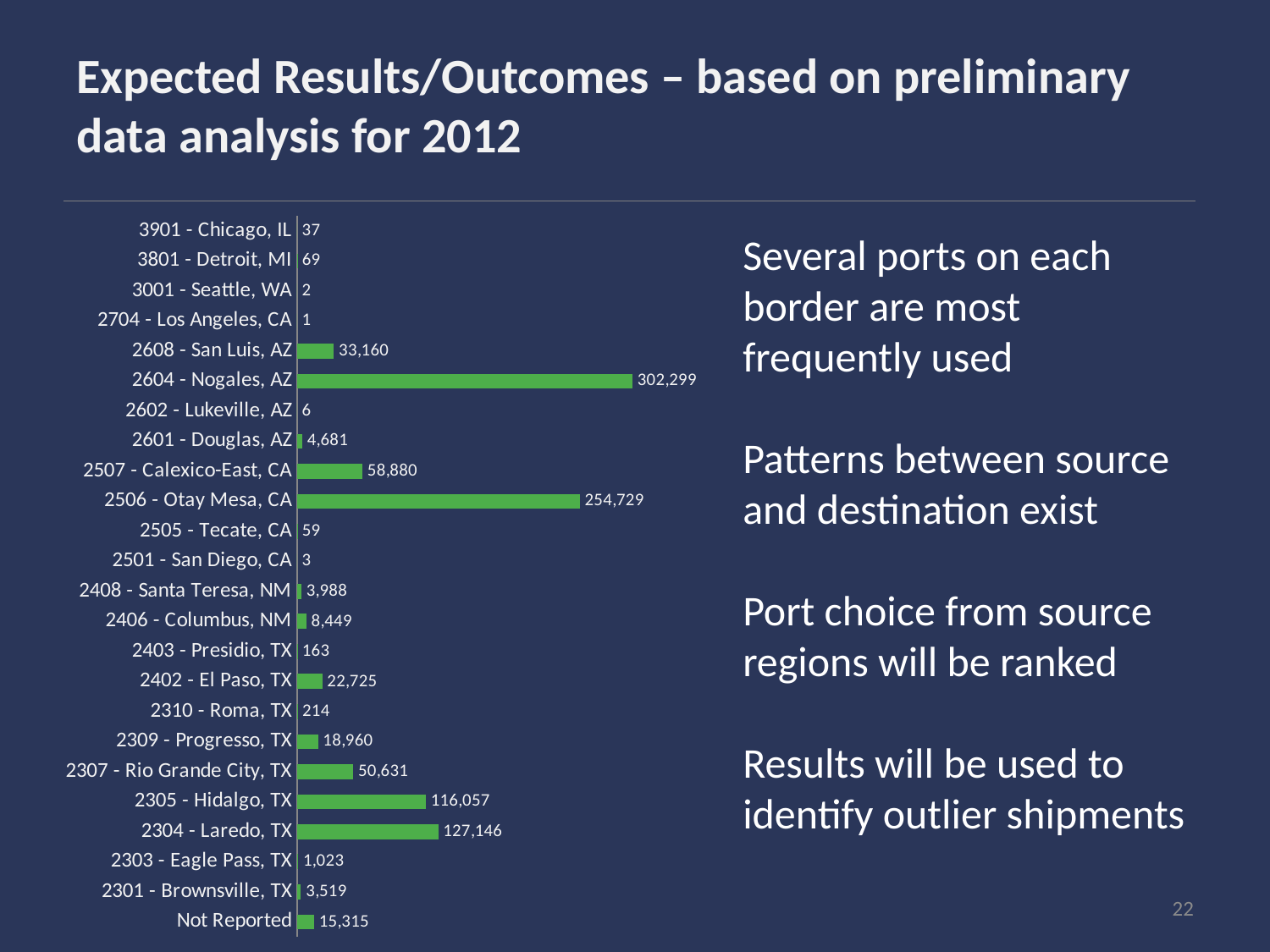
How many categories are shown in the chart? 24 What is the value for Not Reported? 15,315 Which port has the highest value? 2604 - Nogales, AZ Which port has the lowest value? 2704 - Los Angeles, CA What is the value for 2304 - Laredo, TX? 127,146 What is the value for 2507 - Calexico-East, CA? 58,880 What is the difference between the values for 2604 - Nogales, AZ and 2506 - Otay Mesa, CA? 47,570 What kind of chart is shown on the slide? Bar chart Which is larger, the value for 2307 - Rio Grande City, TX or the value for 2309 - Progresso, TX? 2307 - Rio Grande City, TX Which is larger, the value for 2608 - San Luis, AZ or the value for 2402 - El Paso, TX? 2608 - San Luis, AZ What is the value for 2604 - Nogales, AZ? 302,299 What is the difference between the values for 2304 - Laredo, TX and 2305 - Hidalgo, TX? 11,089